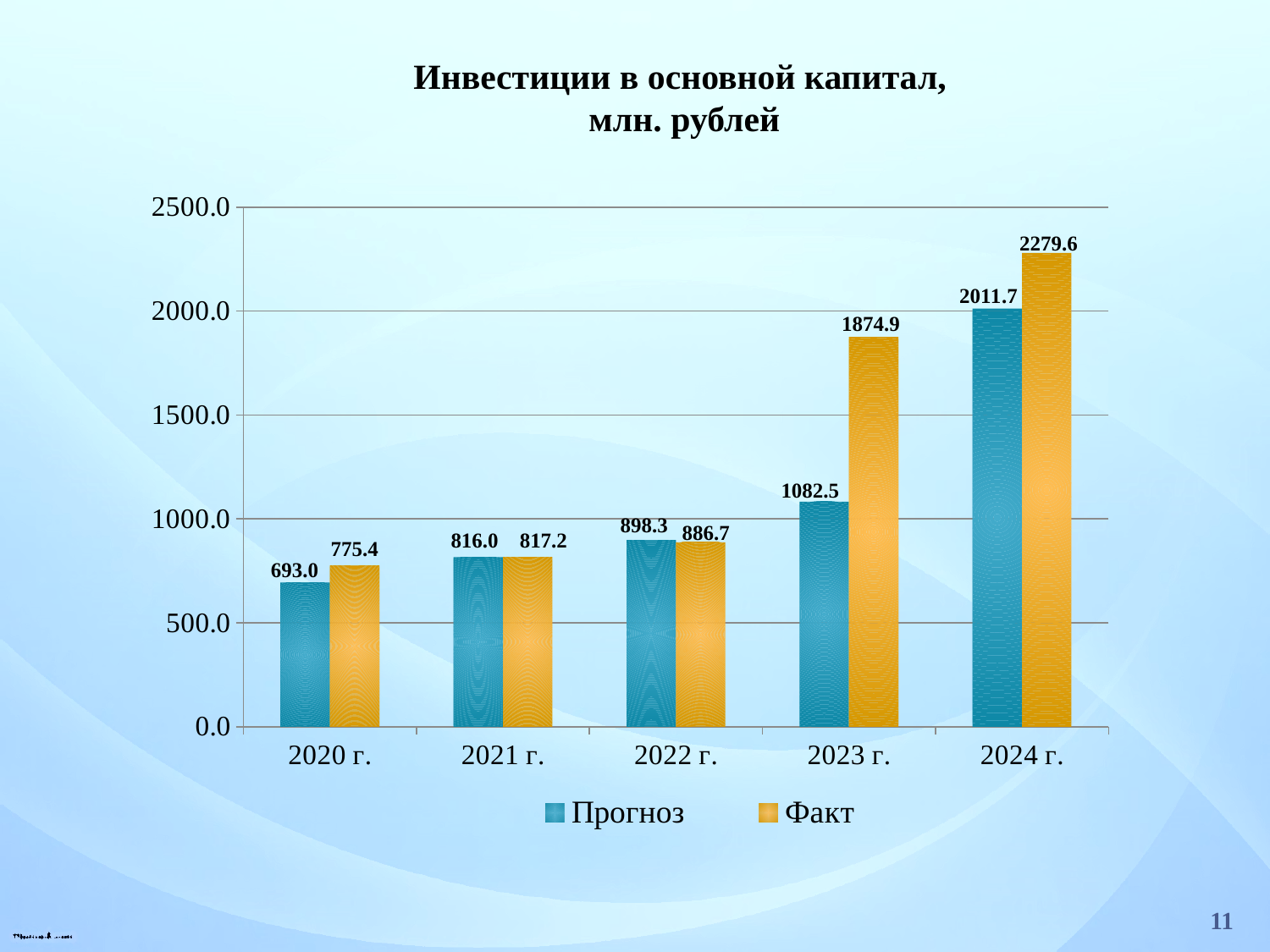
What is the Факт value for 2020 г.? 775.4 How many years are shown on the x axis? 5 How many series does the legend list? 2 Which year has the lowest Прогноз value? 2020 г. Which is larger for 2022 г., the Прогноз value or the Факт value? Прогноз Do the Факт values rise or fall from 2020 г. to 2024 г.? rise What is the Факт value for 2024 г.? 2279.6 Is the Прогноз value for 2024 г. greater or less than 2000.0? greater Which year has the highest Факт value? 2024 г. What is the difference between the Факт and Прогноз values for 2023 г.? 792.4 What kind of chart is shown on the slide? bar chart What is the Прогноз value for 2023 г.? 1082.5